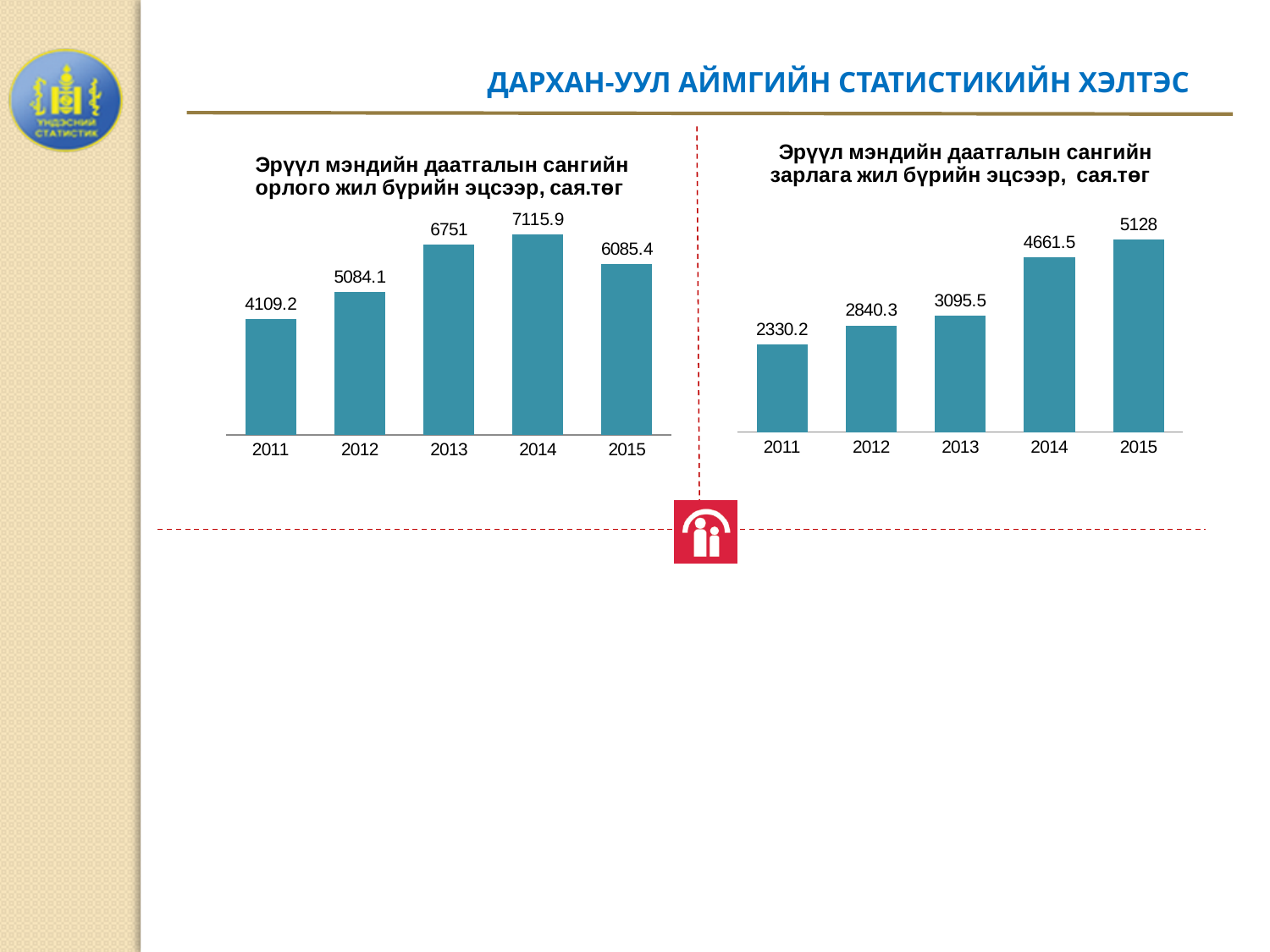
In the right chart (expenditure of the health insurance fund), which year has the lowest value? 2011 In the left chart (income of the health insurance fund), which year has the highest value? 2014 In the left chart (income of the health insurance fund), which is larger, the value for 2015 or the value for 2012? 2015 How many years are shown in the right chart (expenditure of the health insurance fund)? 5 In the right chart (expenditure of the health insurance fund), what is the value for 2014? 4661.5 In the right chart (expenditure of the health insurance fund), what is the difference between the 2015 and 2014 values? 466.5 In the right chart (expenditure of the health insurance fund), do the values rise or fall from 2011 to 2015? rise In the right chart (expenditure of the health insurance fund), which is larger, the value for 2013 or the value for 2012? 2013 In the left chart (income of the health insurance fund), what is the value for 2013? 6751 In the left chart (income of the health insurance fund), what is the difference between the 2014 and 2013 values? 364.9 What kind of chart is the left chart (income of the health insurance fund)? bar chart In the left chart (income of the health insurance fund), what is the value for 2011? 4109.2